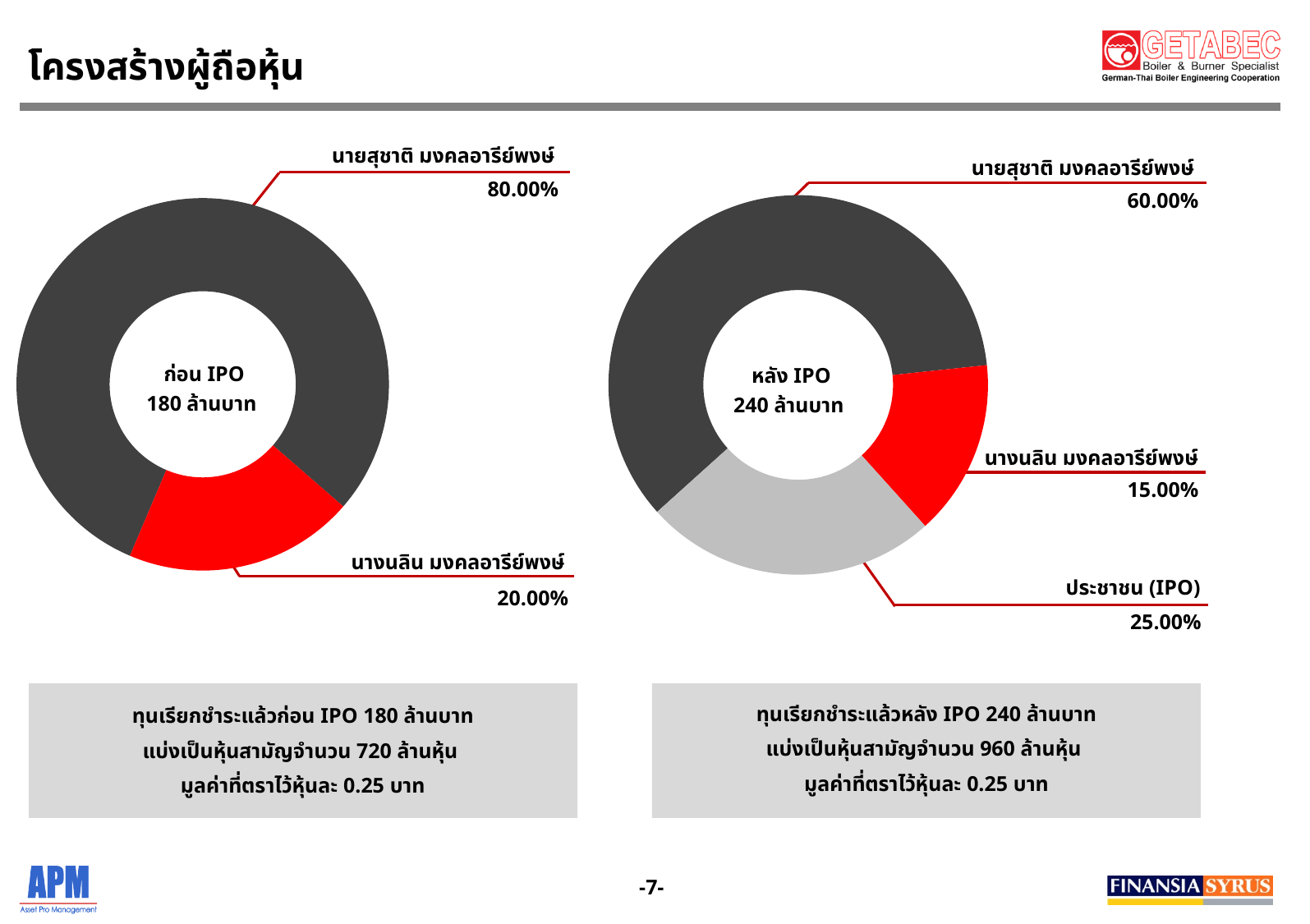
In the left chart (ก่อน IPO), what is the difference between the shares of นายสุชาติ มงคลอารีย์พงษ์ and นางนลิน มงคลอารีย์พงษ์? 60.00% In the right chart (หลัง IPO), what share does นางนลิน มงคลอารีย์พงษ์ hold? 15.00% In the left chart (ก่อน IPO), what share does นายสุชาติ มงคลอารีย์พงษ์ hold? 80.00% In the right chart (หลัง IPO), what share is held by ประชาชน (IPO)? 25.00% In the right chart (หลัง IPO), which shareholder has the largest share? นายสุชาติ มงคลอารีย์พงษ์ In the right chart (หลัง IPO), which shareholder has the smallest share? นางนลิน มงคลอารีย์พงษ์ What type of chart is used on this slide? Doughnut (pie) chart What is the paid-up capital shown in the centre of the right chart (หลัง IPO)? 240 ล้านบาท In the left chart (ก่อน IPO), what share does นางนลิน มงคลอารีย์พงษ์ hold? 20.00% How many shareholder segments are shown in the right chart (หลัง IPO)? 3 In the right chart (หลัง IPO), which is larger: the share of ประชาชน (IPO) or the share of นางนลิน มงคลอารีย์พงษ์? ประชาชน (IPO) In the right chart (หลัง IPO), what share does นายสุชาติ มงคลอารีย์พงษ์ hold? 60.00%